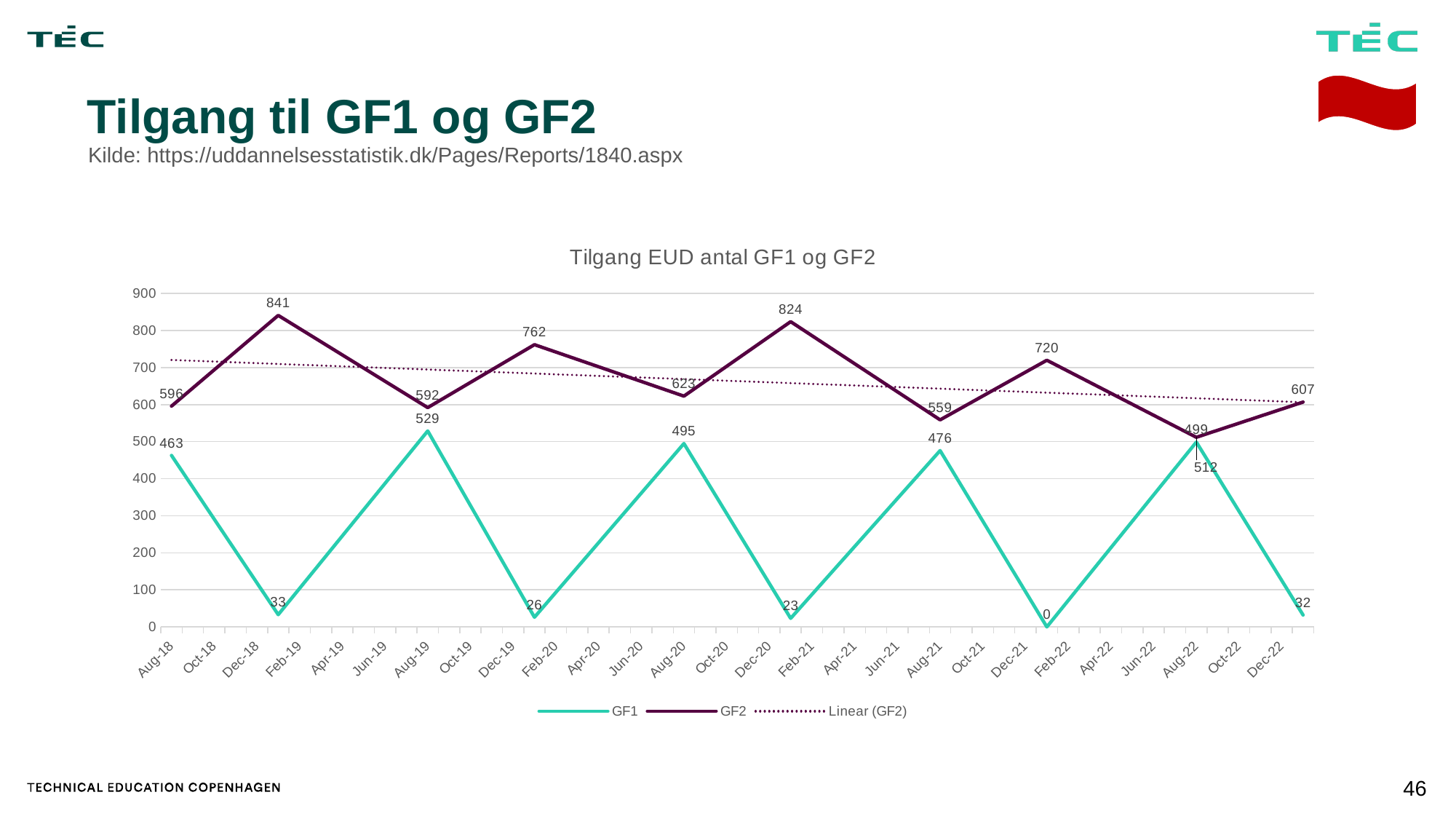
What is the value of GF2 at Aug-18? 596 What is the difference between GF2 and GF1 at Aug-18? 133 What is the title of the chart? Tilgang EUD antal GF1 og GF2 How many series does the legend list? 3 What kind of chart is shown on the slide? line chart What is the value of GF1 at Aug-18? 463 At Aug-22, which series has the larger value, GF1 or GF2? GF2 What is the lowest value shown for GF1? 0 Does the Linear (GF2) trendline rise or fall from left to right? fall What is the value of GF1 at Aug-19? 529 What is the value of GF2 at Aug-20? 623 What is the highest value shown for GF2? 841